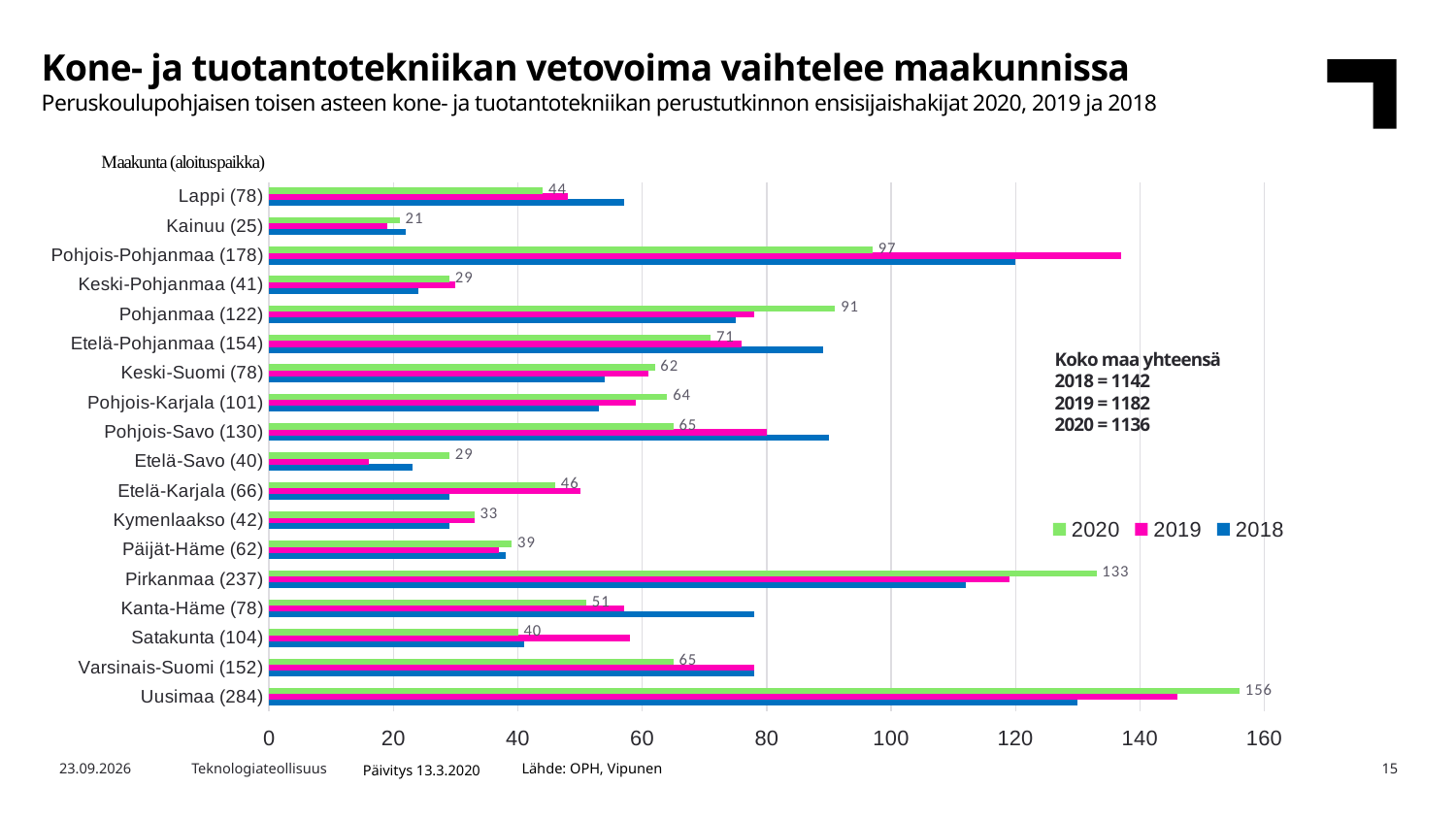
How many series does the legend list? 3 Which region has the lowest 2020 value? Kainuu (25) What is the 2020 value for Uusimaa (284)? 156 What is the 2020 value for Pirkanmaa (237)? 133 Which region has the highest 2020 value? Uusimaa (284) Is the 2018 value for Kanta-Häme (78) greater or less than 60? greater What is the 2020 value for Etelä-Pohjanmaa (154)? 71 Is the 2019 value for Pohjois-Pohjanmaa (178) greater or less than 120? greater What kind of chart is shown on the slide? Bar chart For Pirkanmaa (237), which is larger: the 2020 value or the 2019 value? 2020 How many regions are shown on the chart? 18 What is the difference between the 2020 values for Uusimaa (284) and Pirkanmaa (237)? 23